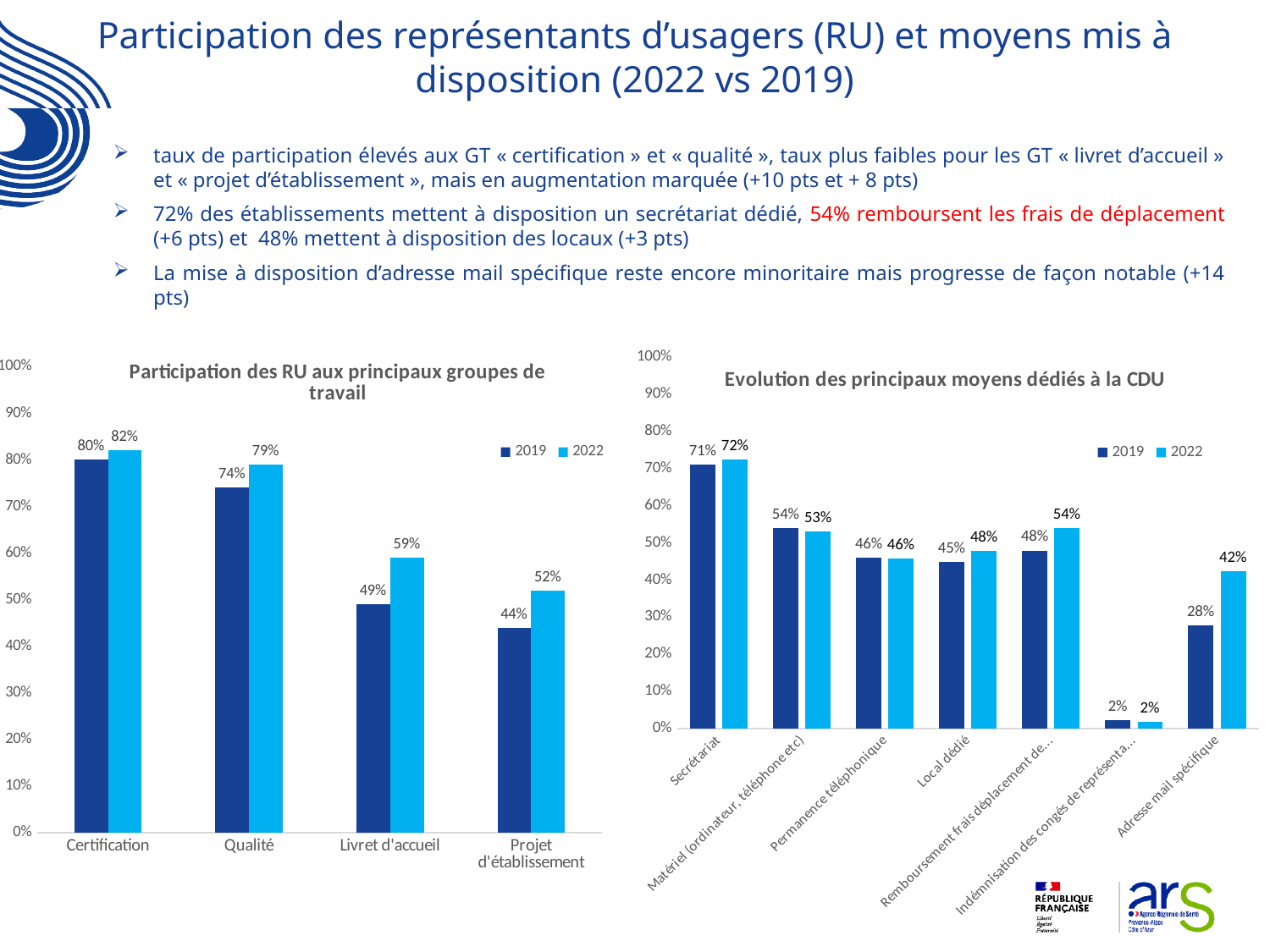
In the chart 'Participation des RU aux principaux groupes de travail', what is the 2022 value for Certification? 82% In the chart 'Participation des RU aux principaux groupes de travail', which category has the lowest 2019 value? Projet d'établissement In the chart 'Participation des RU aux principaux groupes de travail', what is the difference between the 2022 and 2019 values for Livret d'accueil? 10 points In the chart 'Evolution des principaux moyens dédiés à la CDU', what is the difference between the 2022 and 2019 values for Adresse mail spécifique? 14 points In the chart 'Participation des RU aux principaux groupes de travail', how many categories are shown on the x axis? 4 In the chart 'Evolution des principaux moyens dédiés à la CDU', which is larger: the 2019 value for Local dédié or the 2022 value for Local dédié? 2022 (48%) In the chart 'Evolution des principaux moyens dédiés à la CDU', what is the 2019 value for Adresse mail spécifique? 28% In the chart 'Participation des RU aux principaux groupes de travail', how many series does the legend list? 2 What type of chart is 'Evolution des principaux moyens dédiés à la CDU'? Bar chart In the chart 'Evolution des principaux moyens dédiés à la CDU', what is the 2022 value for Secrétariat? 72% In the chart 'Evolution des principaux moyens dédiés à la CDU', which category has the highest 2022 value? Secrétariat In the chart 'Participation des RU aux principaux groupes de travail', what is the 2019 value for Livret d'accueil? 49%